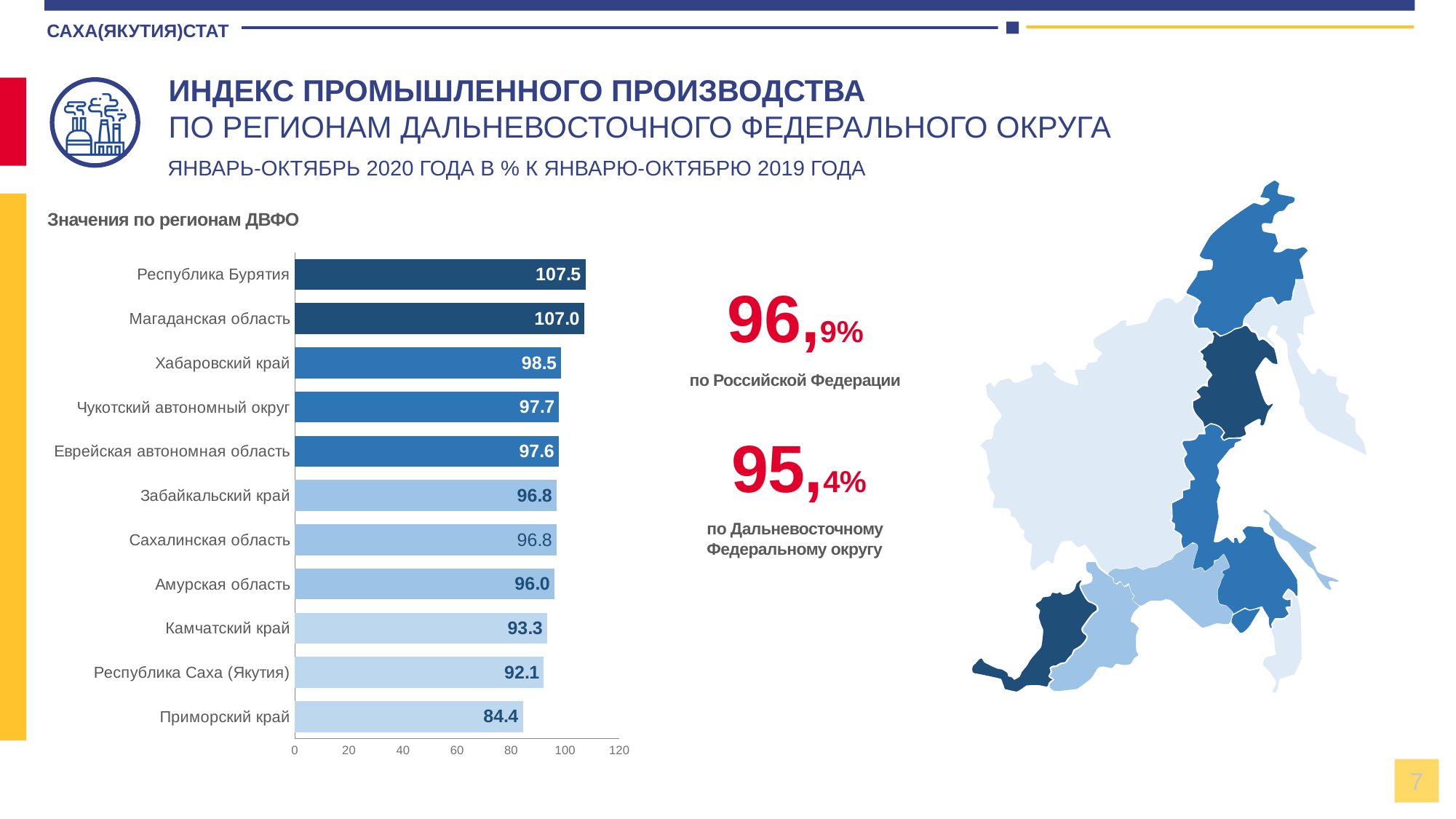
What is the value for Республика Бурятия? 107.5 What is the value for Приморский край? 84.4 What is the value for Республика Саха (Якутия)? 92.1 What kind of chart is used to show the values by region? bar chart Which region has the lowest value? Приморский край What is the maximum value shown on the x axis of the bar chart? 120 Which region has the highest value? Республика Бурятия How many regions are shown in the bar chart? 11 Is the value for Камчатский край greater or less than 100? less What is the difference between the values for Республика Бурятия and Приморский край? 23.1 What is the difference between the values for Магаданская область and Хабаровский край? 8.5 Which is larger, the value for Хабаровский край or the value for Амурская область? Хабаровский край